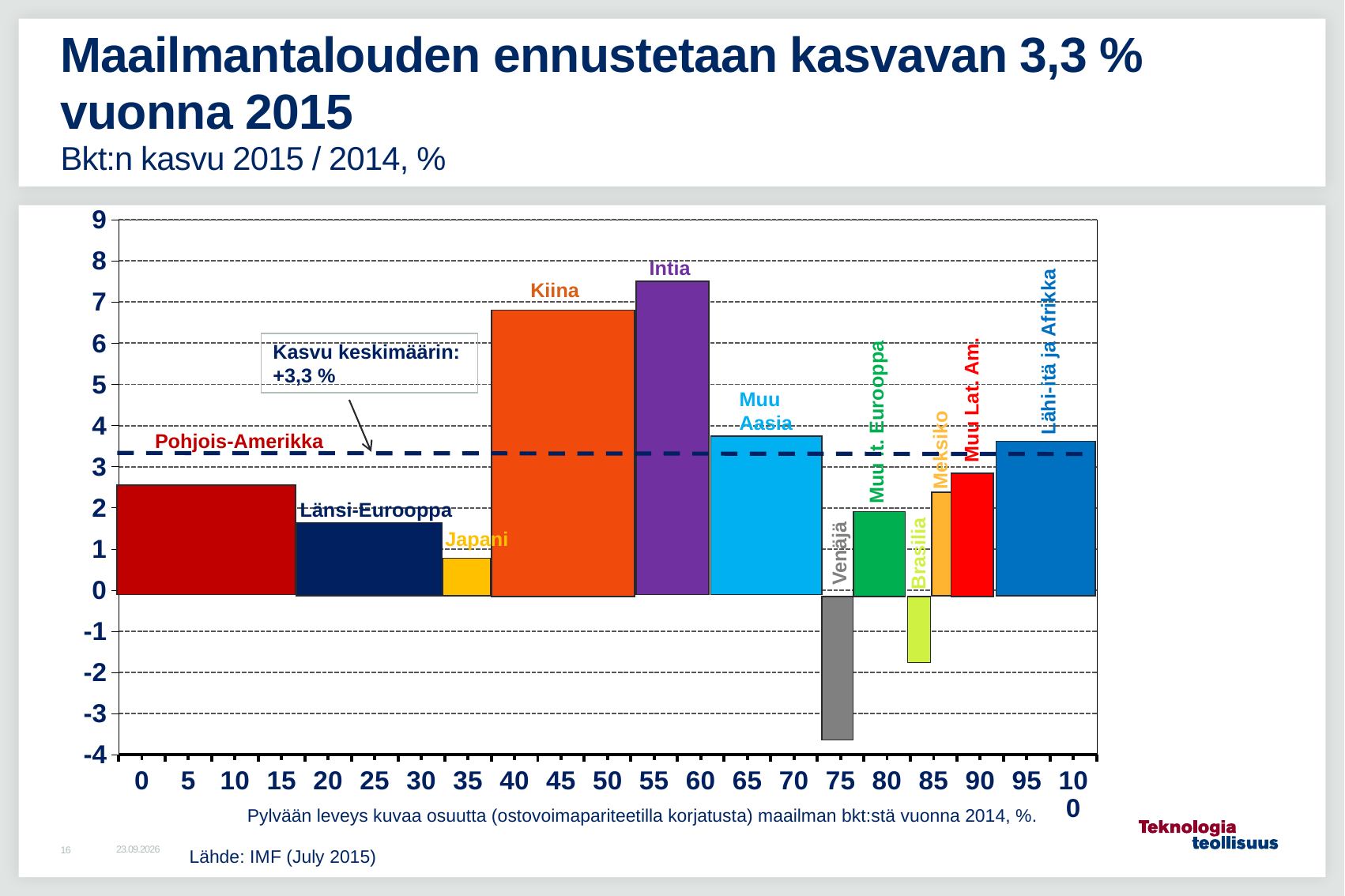
Which has the higher growth, Kiina or Intia? Intia According to the slide, what is the source of the chart data? IMF (July 2015) Is the value for Pohjois-Amerikka greater or less than 3? less Is the value for Japani greater or less than 1? less What type of chart is shown on the slide? bar chart How many regions are shown as bars in the chart? 12 What is the average growth value shown by the dashed line in the chart? +3,3 % Which region has the lowest GDP growth in the chart? Venäjä Is the value for Venäjä greater or less than -3? less Which region has the highest GDP growth in the chart? Intia Which has the higher growth, Venäjä or Brasilia? Brasilia